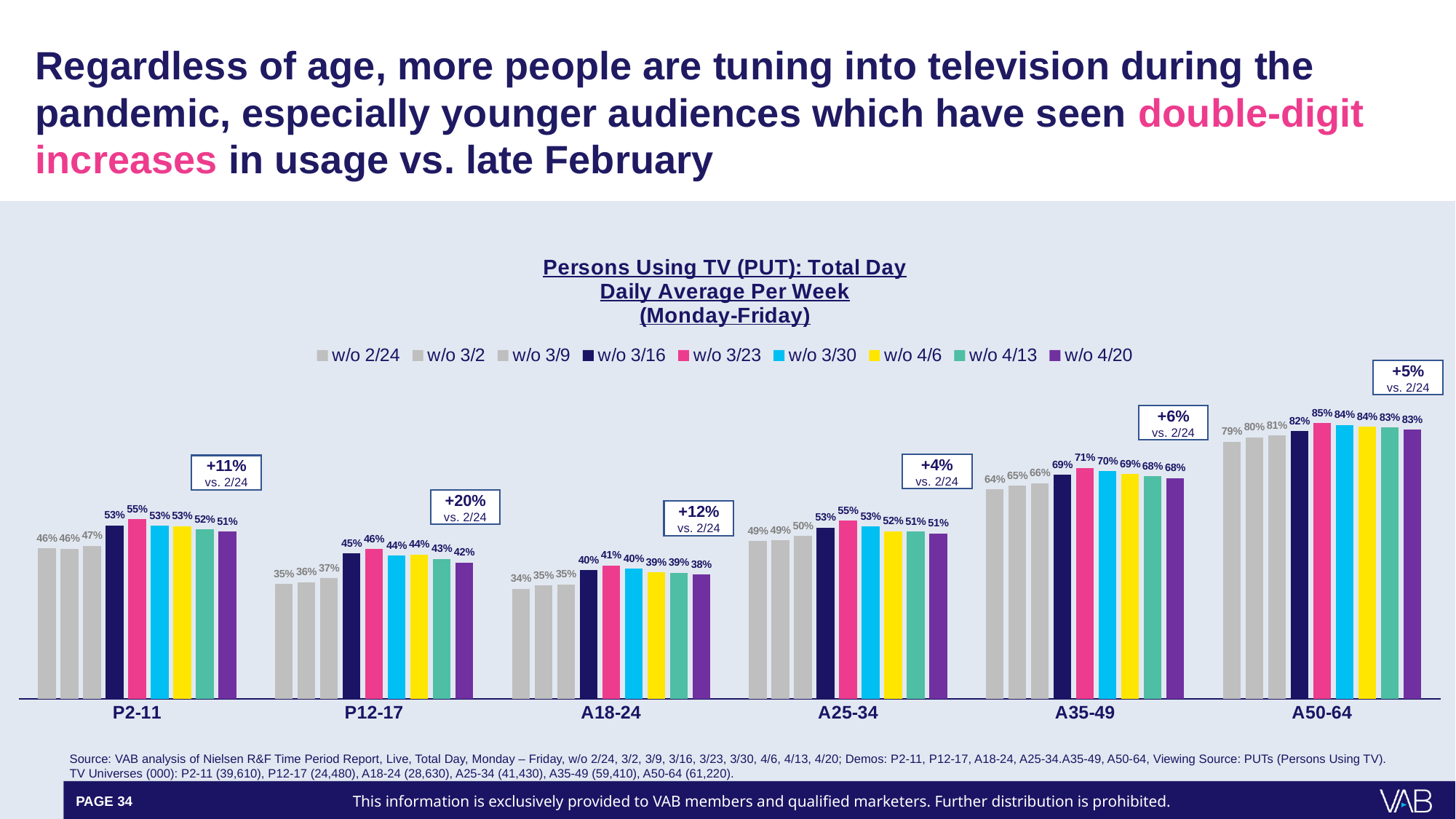
What is the value for A18-24 in the w/o 4/20 series? 38% Which age group has the lowest value in the w/o 2/24 series? A18-24 What kind of chart is shown on the slide? Bar chart What is the difference between the w/o 3/23 and w/o 2/24 values for A35-49? 7% How many series does the legend list? 9 What is the value for A50-64 in the w/o 3/23 series? 85% What is the value for P12-17 in the w/o 2/24 series? 35% Which age group has the highest value in the w/o 3/23 series? A50-64 How many age groups are shown on the x axis? 6 What percentage increase vs. 2/24 is called out for P12-17? +20% Across the weeks from w/o 2/24 to w/o 3/23, do the values for A25-34 rise or fall? Rise Which is larger for P2-11: the w/o 3/16 value or the w/o 4/20 value? w/o 3/16